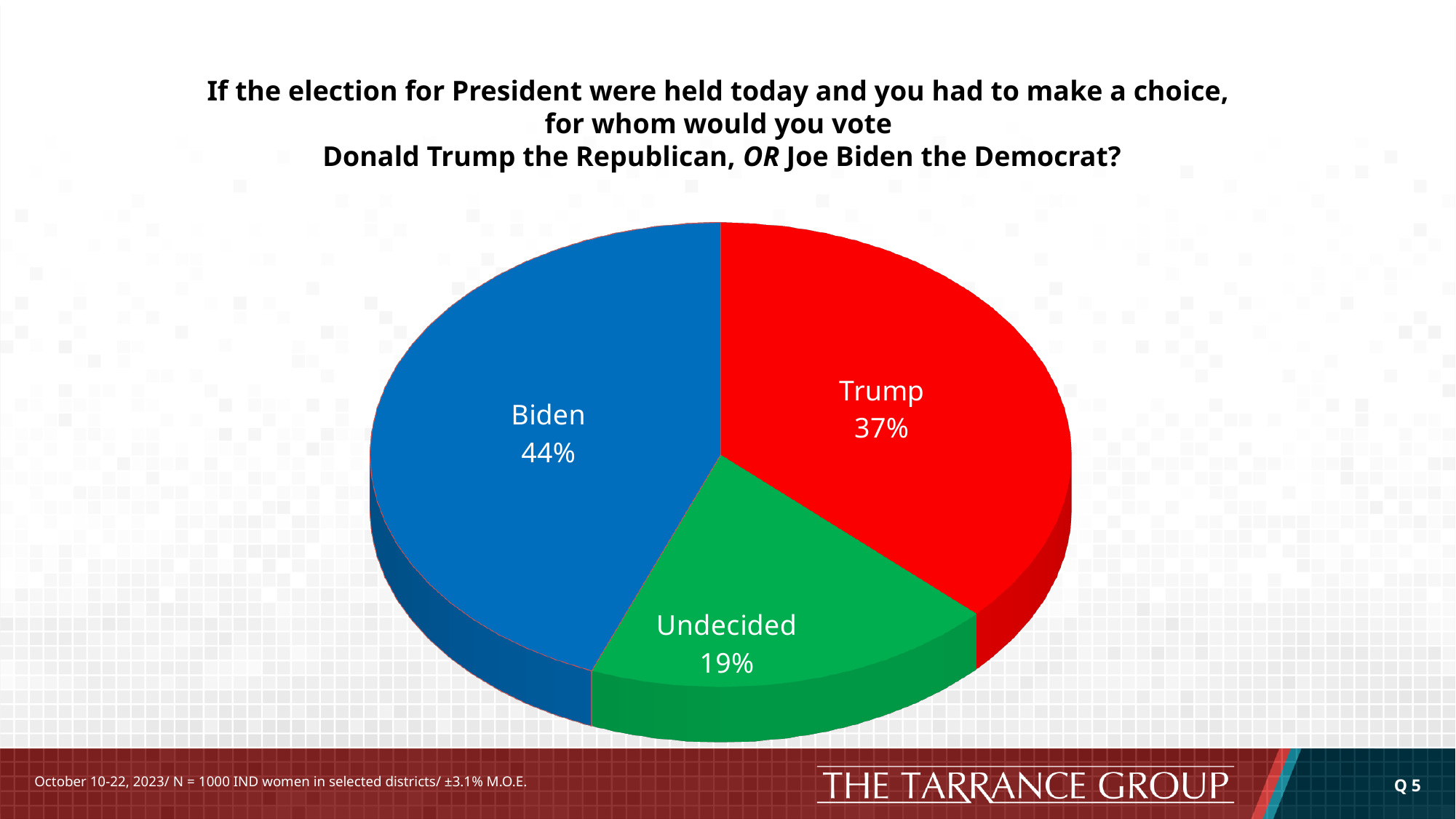
What is the difference in percentage points between Biden and Trump? 7 How many slices does the pie chart have? 3 What colour is the Trump slice? Red Which slice of the pie is the largest? Biden What percentage of respondents said they would vote for Biden? 44% What percentage of respondents said they would vote for Trump? 37% What is the difference in percentage points between Trump and Undecided? 18 What colour is the Undecided slice? Green What percentage of respondents are Undecided? 19% Which slice of the pie is the smallest? Undecided What kind of chart is shown on the slide? Pie chart Which is larger, the share for Trump or the share for Undecided? Trump